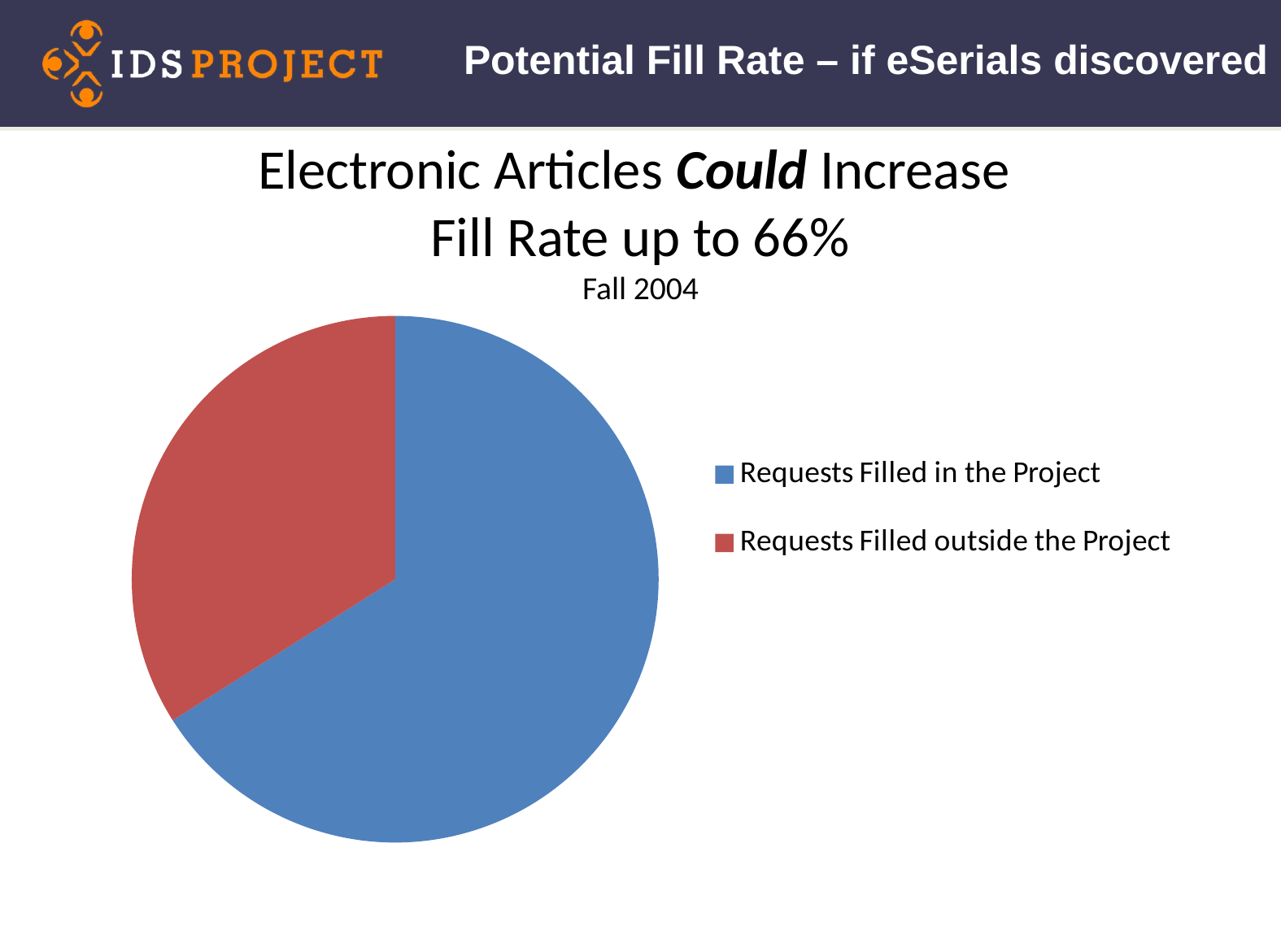
Does the slice for Requests Filled in the Project take up more or less than half of the pie? more How many entries does the legend of the pie chart list? 2 What colour is the slice for Requests Filled outside the Project? red Does the slice for Requests Filled outside the Project take up more or less than half of the pie? less Which category has the largest slice of the pie chart? Requests Filled in the Project Which is larger in the pie chart: Requests Filled in the Project or Requests Filled outside the Project? Requests Filled in the Project What kind of chart is shown on the slide? pie chart What is the title shown directly above the pie chart? Fall 2004 Which category has the smallest slice of the pie chart? Requests Filled outside the Project How many slices does the pie chart have? 2